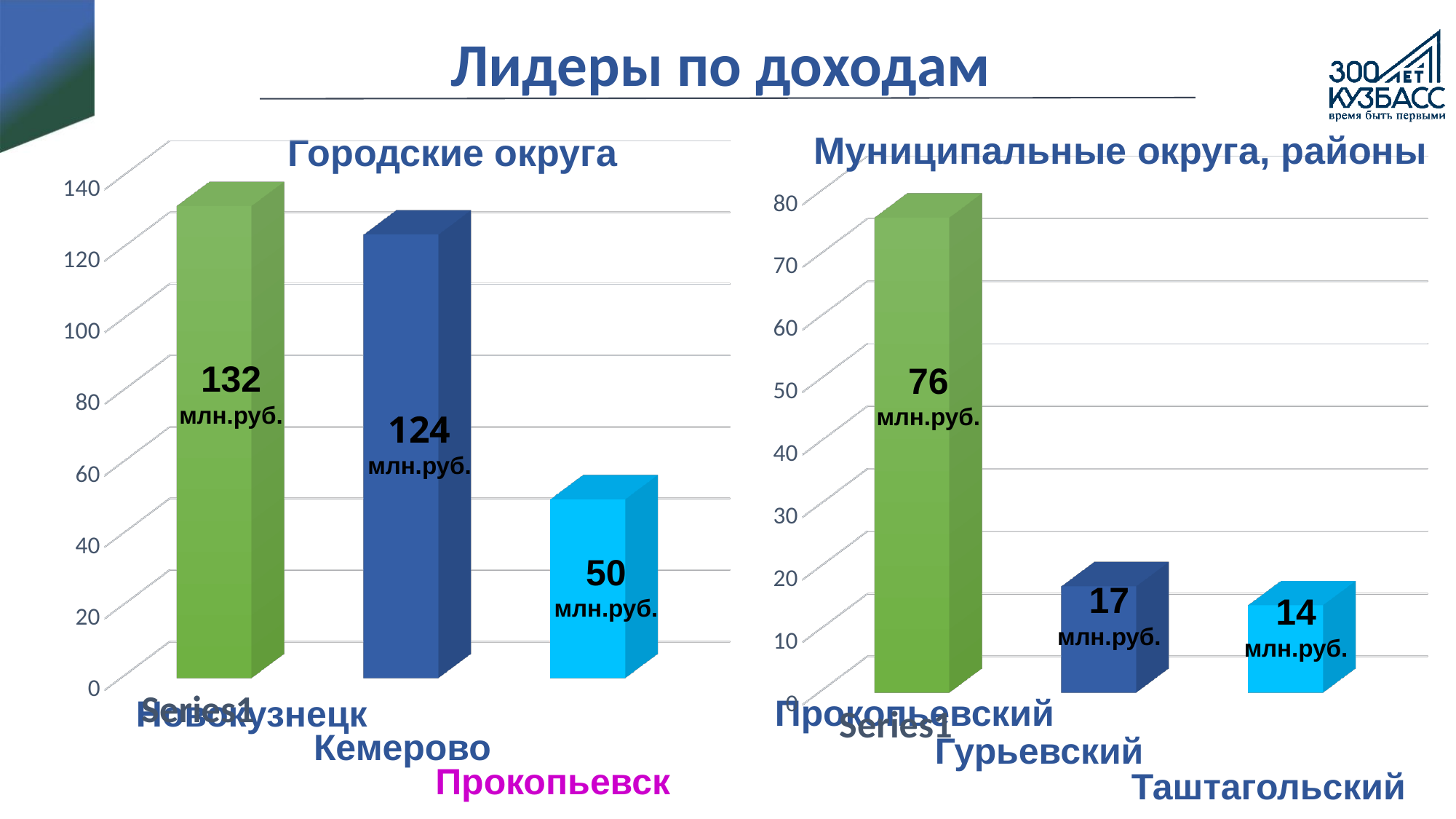
In the 'Муниципальные округа, районы' chart, what is the difference between the values for Прокопьевский and Таштагольский? 62 млн.руб. In the 'Городские округа' chart, what is the difference between the values for Новокузнецк and Кемерово? 8 млн.руб. In the 'Муниципальные округа, районы' chart, which category has the highest value? Прокопьевский In the 'Муниципальные округа, районы' chart, which is larger: the value for Гурьевский or Таштагольский? Гурьевский In the 'Муниципальные округа, районы' chart, what is the value for Гурьевский? 17 млн.руб. What is the title of the slide? Лидеры по доходам In the 'Городские округа' chart, which category has the lowest value? Прокопьевск In the 'Городские округа' chart, is the value for Кемерово greater or less than 100? greater What kind of chart is the 'Городские округа' chart? bar chart In the 'Городские округа' chart, what is the value for Прокопьевск? 50 млн.руб. How many categories are shown in the 'Муниципальные округа, районы' chart? 3 In the 'Городские округа' chart, what is the value for Новокузнецк? 132 млн.руб.